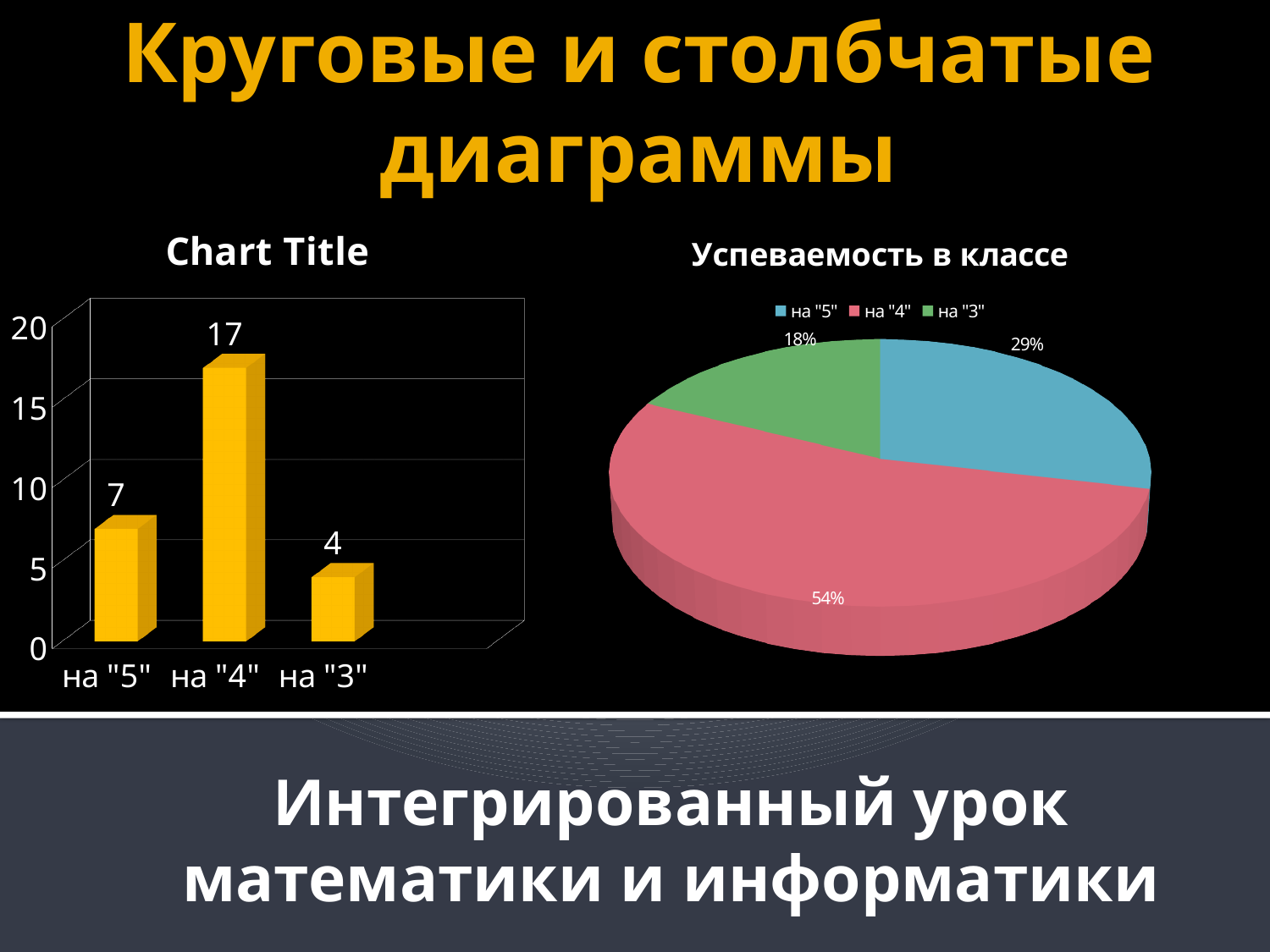
In the pie chart titled "Успеваемость в классе", what colour is the slice for на "5"? blue In the bar chart titled "Chart Title", which category has the lowest value? на "3" In the bar chart titled "Chart Title", what is the value for на "4"? 17 What kind of chart is the one titled "Chart Title"? bar chart In the bar chart titled "Chart Title", how many categories are shown on the x axis? 3 In the bar chart titled "Chart Title", what is the difference between the values for на "4" and на "5"? 10 In the pie chart titled "Успеваемость в классе", which slice is the largest? на "4" In the pie chart titled "Успеваемость в классе", how many entries does the legend list? 3 In the bar chart titled "Chart Title", which category has the highest value? на "4" In the pie chart titled "Успеваемость в классе", what share does на "4" have? 54% In the bar chart titled "Chart Title", what is the value for на "5"? 7 In the pie chart titled "Успеваемость в классе", what share does на "3" have? 18%